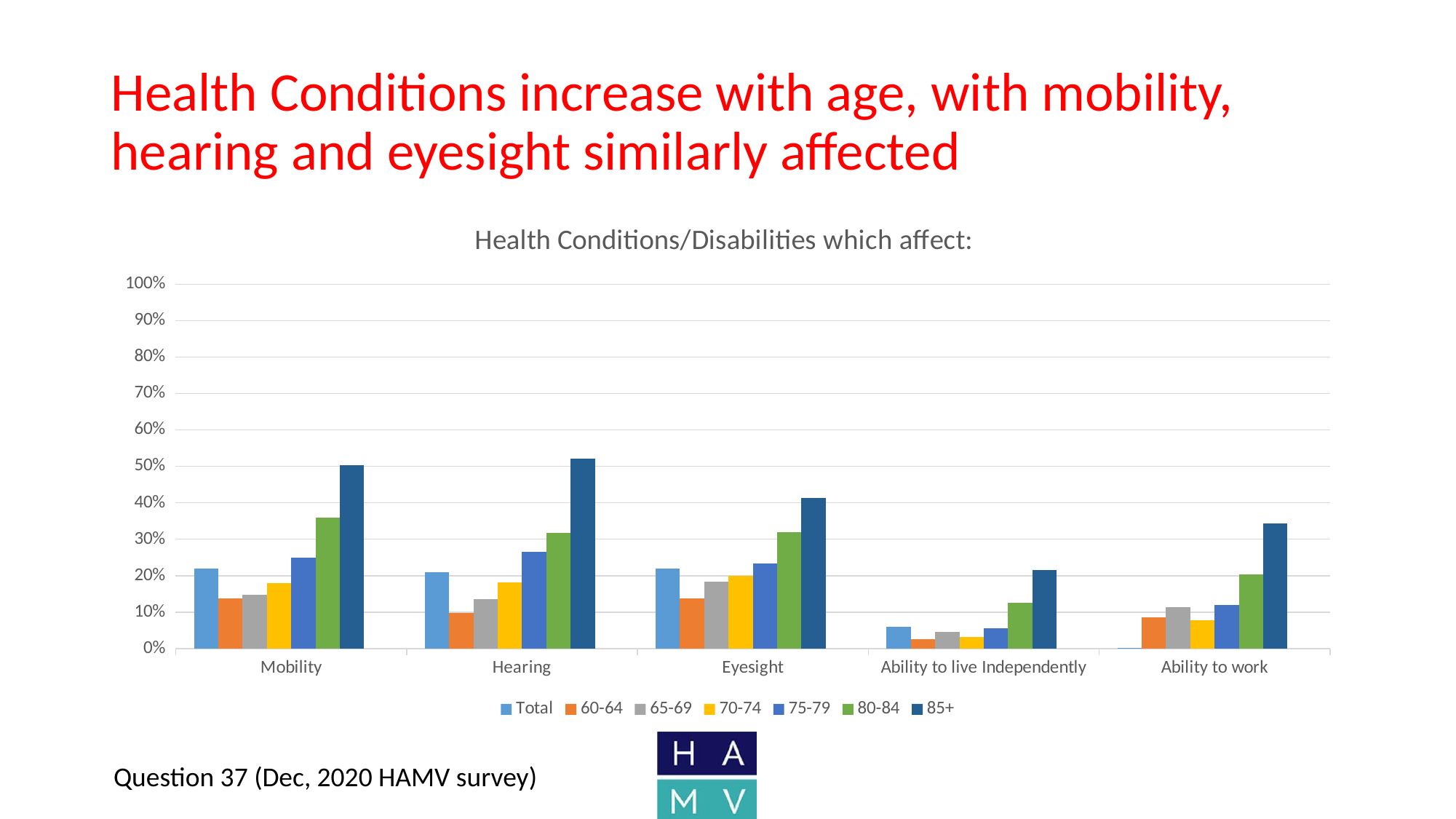
What is the title of the chart? Health Conditions/Disabilities which affect: What kind of chart is shown on the slide? bar chart Is the value for the 85+ group under Mobility greater or less than 40%? greater Which age group has the lowest value under Hearing? 60-64 How many series does the chart legend list? 7 Which category has the lowest value for the 85+ group? Ability to live Independently Is the value for the 60-64 group under Hearing greater or less than 20%? less Which is larger: the 85+ value for Ability to work or the 85+ value for Ability to live Independently? Ability to work How many categories are shown on the x axis of the chart? 5 Is the value for the 85+ group under Eyesight greater or less than 30%? greater Which age group has the highest value under Mobility? 85+